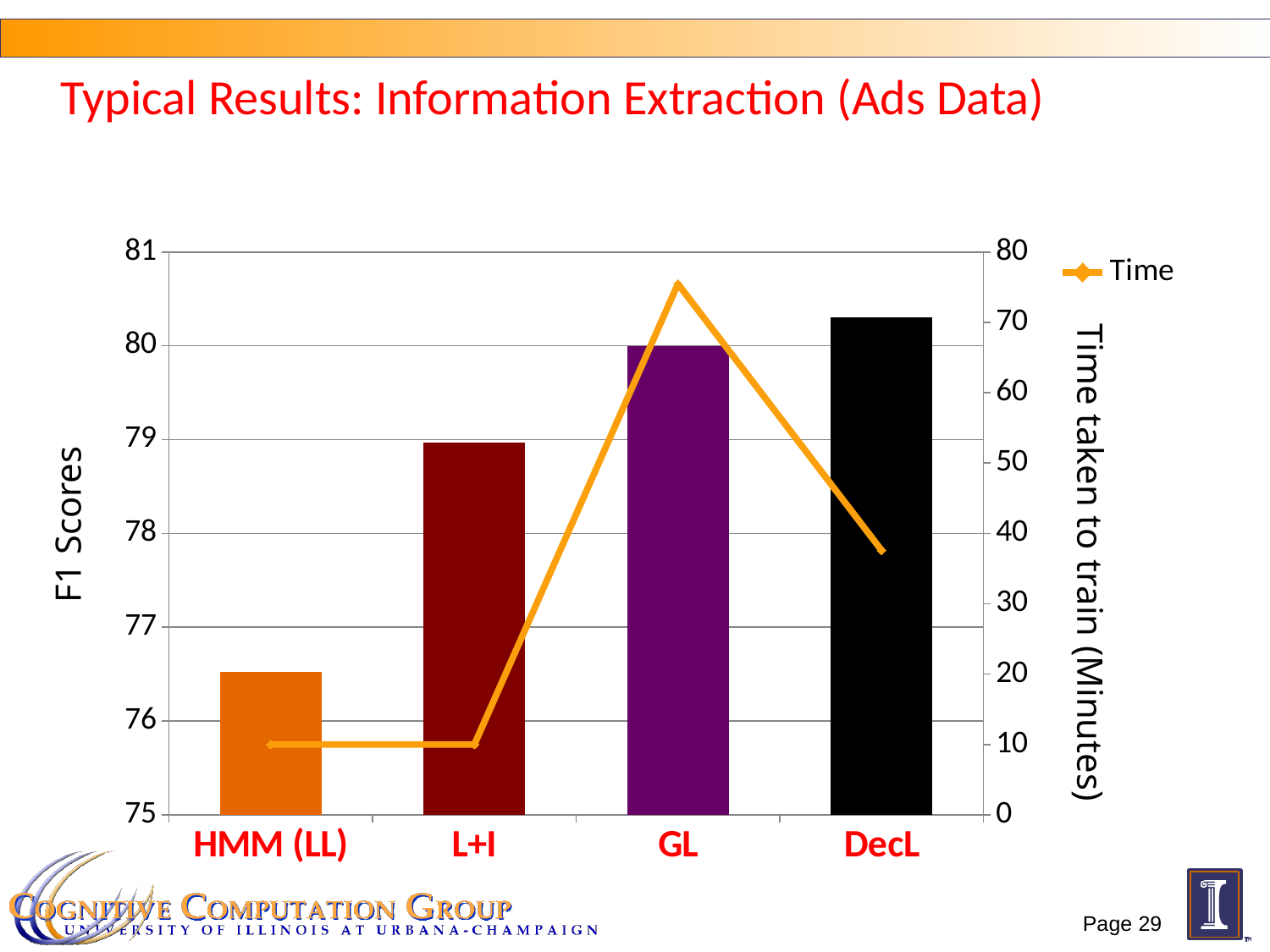
How many series does the chart's legend list? 1 Which category has the highest F1 score bar? DecL Which has the larger F1 score, L+I or GL? GL What is the title of the right-hand vertical axis? Time taken to train (Minutes) Which category has the highest value on the Time line? GL Is the Time value for GL greater or less than 70? greater Is the F1 score for L+I greater or less than 78? greater Is the F1 score for HMM (LL) greater or less than 77? less Which has the larger Time value, GL or DecL? GL Which category has the lowest F1 score bar? HMM (LL) How many categories are shown on the x axis of the chart? 4